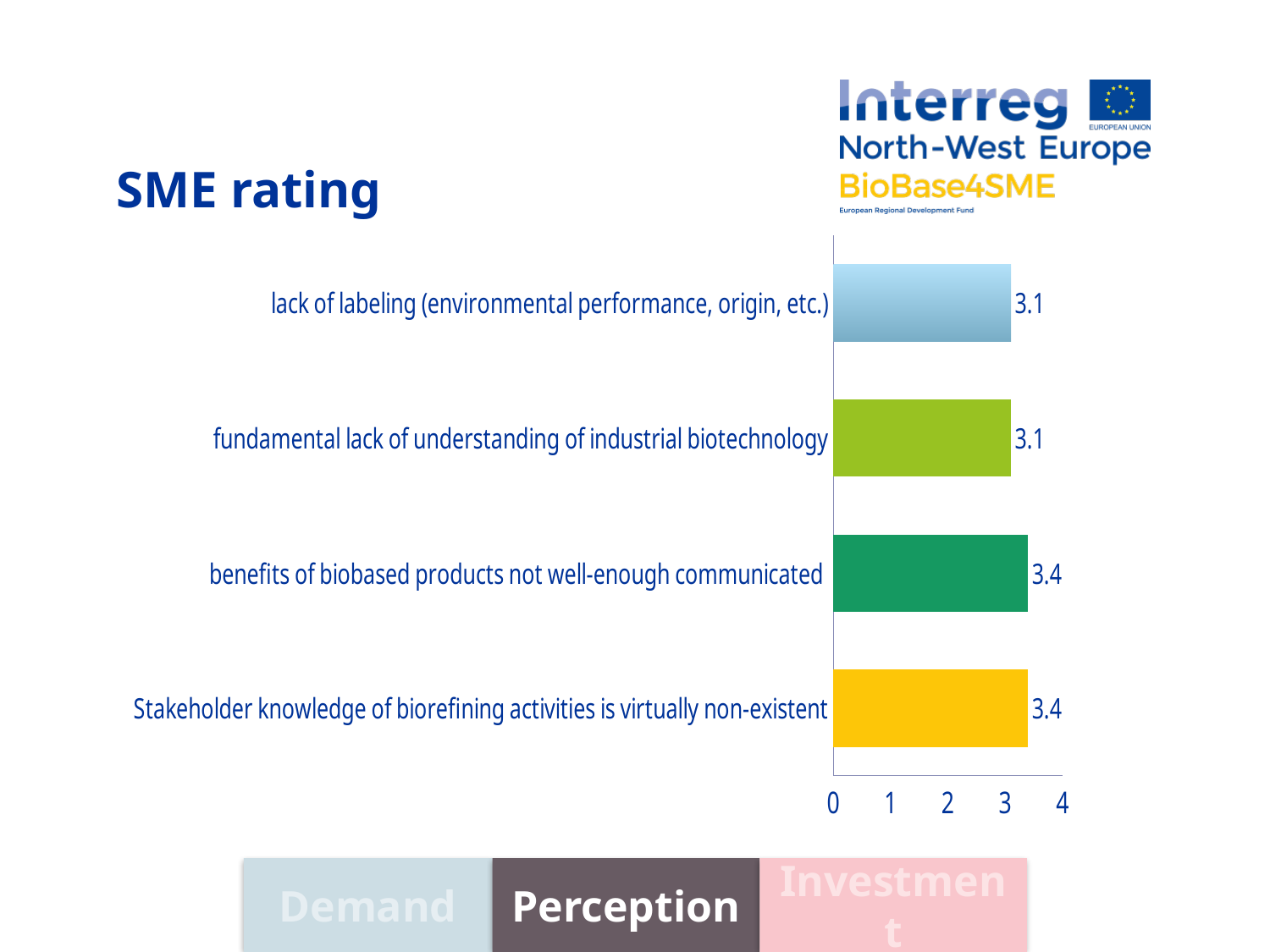
Which is larger: the rating for 'Stakeholder knowledge of biorefining activities is virtually non-existent' or the rating for 'fundamental lack of understanding of industrial biotechnology'? Stakeholder knowledge of biorefining activities is virtually non-existent What is the SME rating for 'fundamental lack of understanding of industrial biotechnology'? 3.1 What is the title of the slide containing the chart? SME rating Is the rating for 'lack of labeling (environmental performance, origin, etc.)' greater or less than 3? greater What kind of chart is shown on the slide? bar chart Is the rating for 'benefits of biobased products not well-enough communicated' greater or less than 4? less What is the SME rating for 'benefits of biobased products not well-enough communicated'? 3.4 What is the maximum value shown on the chart's value axis? 4 What is the SME rating for 'lack of labeling (environmental performance, origin, etc.)'? 3.1 What is the SME rating for 'Stakeholder knowledge of biorefining activities is virtually non-existent'? 3.4 What is the difference between the rating for 'benefits of biobased products not well-enough communicated' and the rating for 'lack of labeling (environmental performance, origin, etc.)'? 0.3 How many categories are shown in the chart? 4